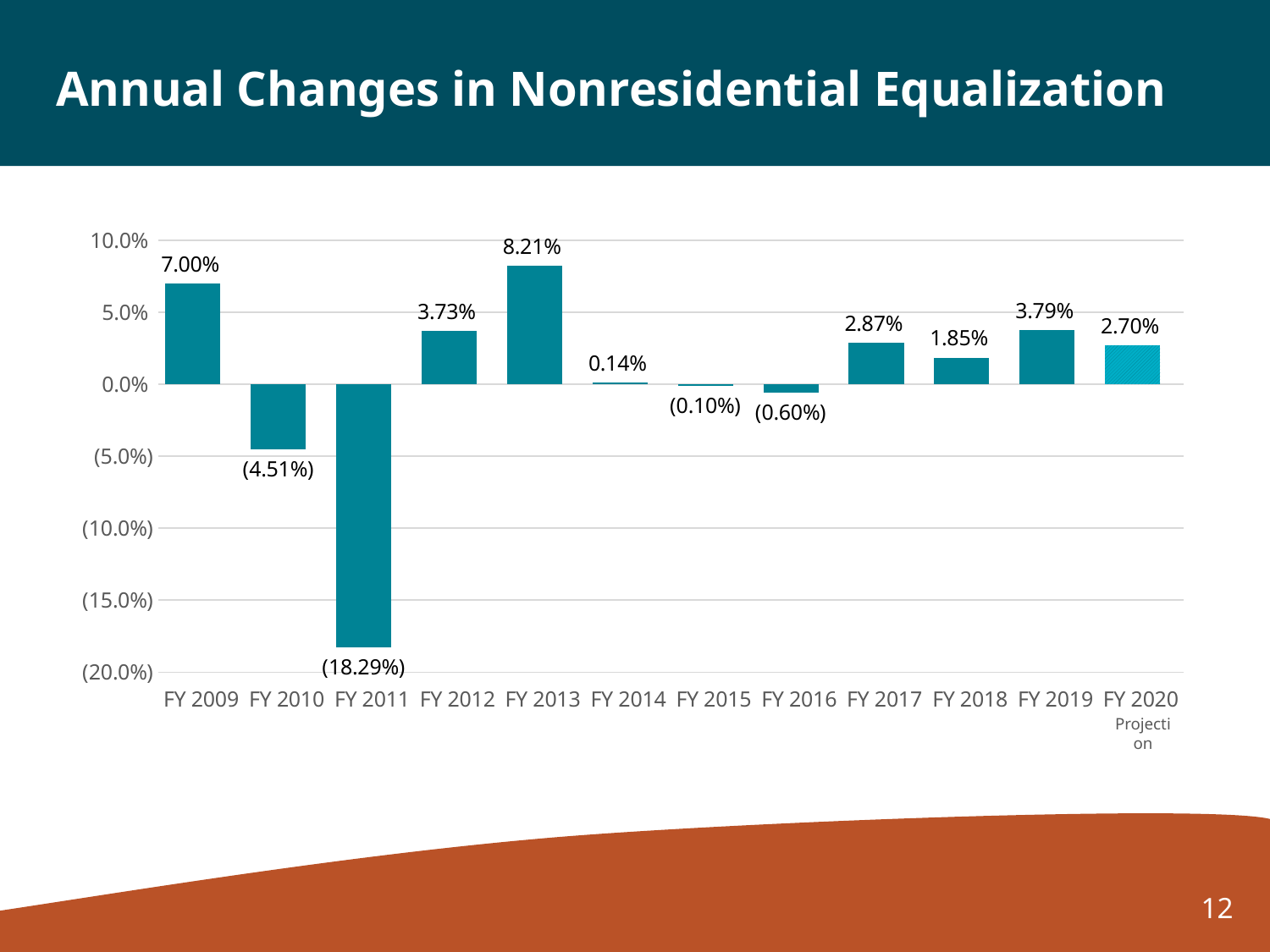
What is the title of the slide? Annual Changes in Nonresidential Equalization What is the value shown for FY 2011? (18.29%) What is the difference between the values for FY 2013 and FY 2009? 1.21% Which fiscal year has the highest annual change? FY 2013 Is the value for FY 2010 greater or less than (5.0%)? greater What is the annual change in nonresidential equalization for FY 2013? 8.21% Which fiscal year has the lowest annual change? FY 2011 Which is larger, the value for FY 2017 or the value for FY 2018? FY 2017 What is the value shown for FY 2016? (0.60%) What kind of chart is shown on the slide? Bar chart What is the value shown for FY 2020 Projection? 2.70% How many fiscal years are shown on the x axis? 12